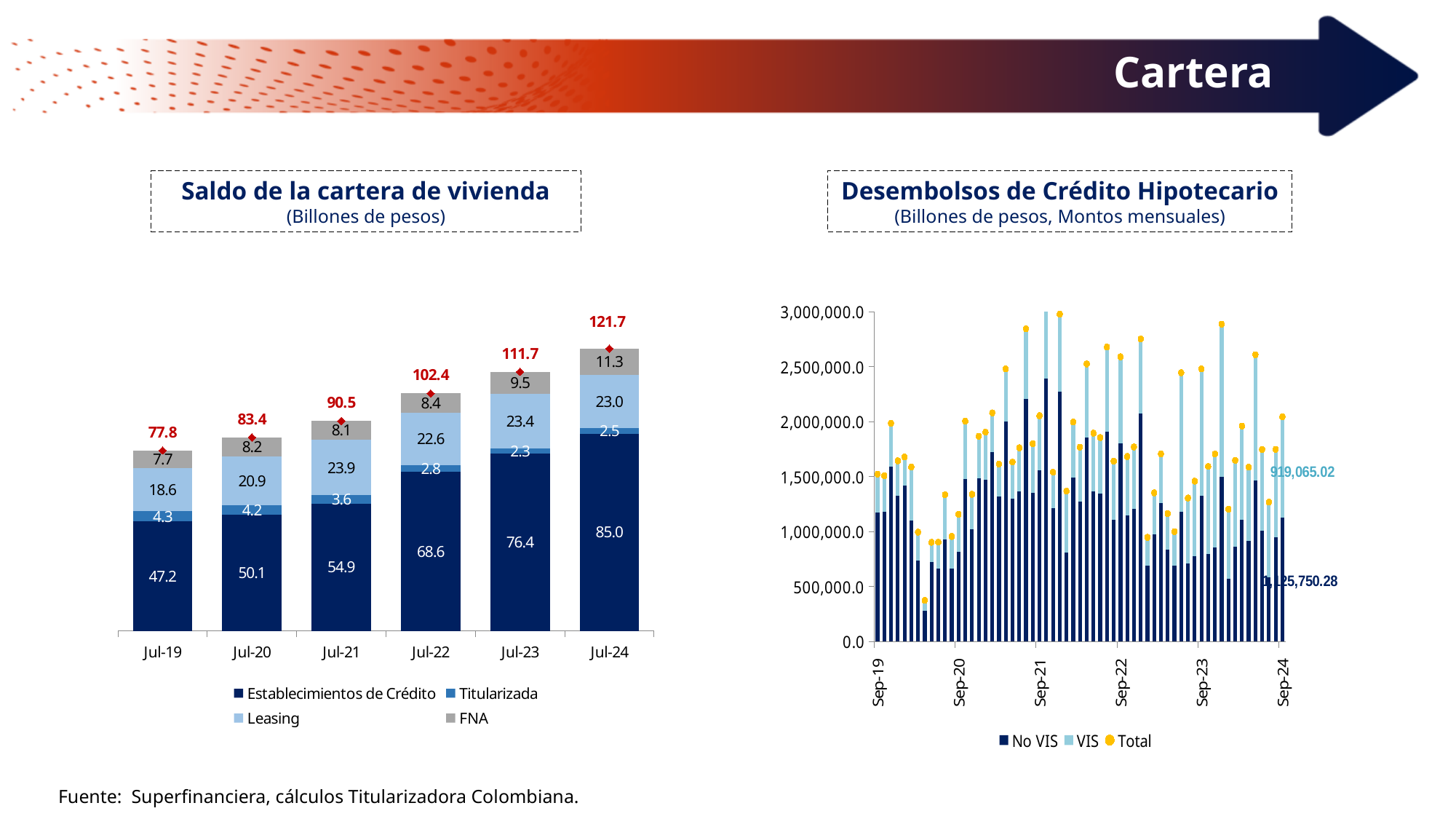
In the 'Saldo de la cartera de vivienda' chart, what is the difference between the Jul-24 total and the Jul-23 total? 10.0 How many entries does the legend of the 'Desembolsos de Crédito Hipotecario' chart list? 3 How many periods are shown on the x axis of the 'Saldo de la cartera de vivienda' chart? 6 In the 'Saldo de la cartera de vivienda' chart, what is the total shown above the Jul-22 bar? 102.4 In the 'Desembolsos de Crédito Hipotecario' chart, what is the VIS value labelled for Sep-24? 919,065.02 In the 'Saldo de la cartera de vivienda' chart, which period has the lowest Titularizada value? Jul-23 In the 'Saldo de la cartera de vivienda' chart, is the Leasing value larger in Jul-21 or Jul-24? Jul-21 In the 'Saldo de la cartera de vivienda' chart, do the totals rise or fall from Jul-19 to Jul-24? rise In the 'Saldo de la cartera de vivienda' chart, what is the value for Establecimientos de Crédito in Jul-24? 85.0 In the 'Saldo de la cartera de vivienda' chart, what is the FNA value for Jul-19? 7.7 In the 'Saldo de la cartera de vivienda' chart, which period has the highest total? Jul-24 How many series does the legend of the 'Saldo de la cartera de vivienda' chart list? 4